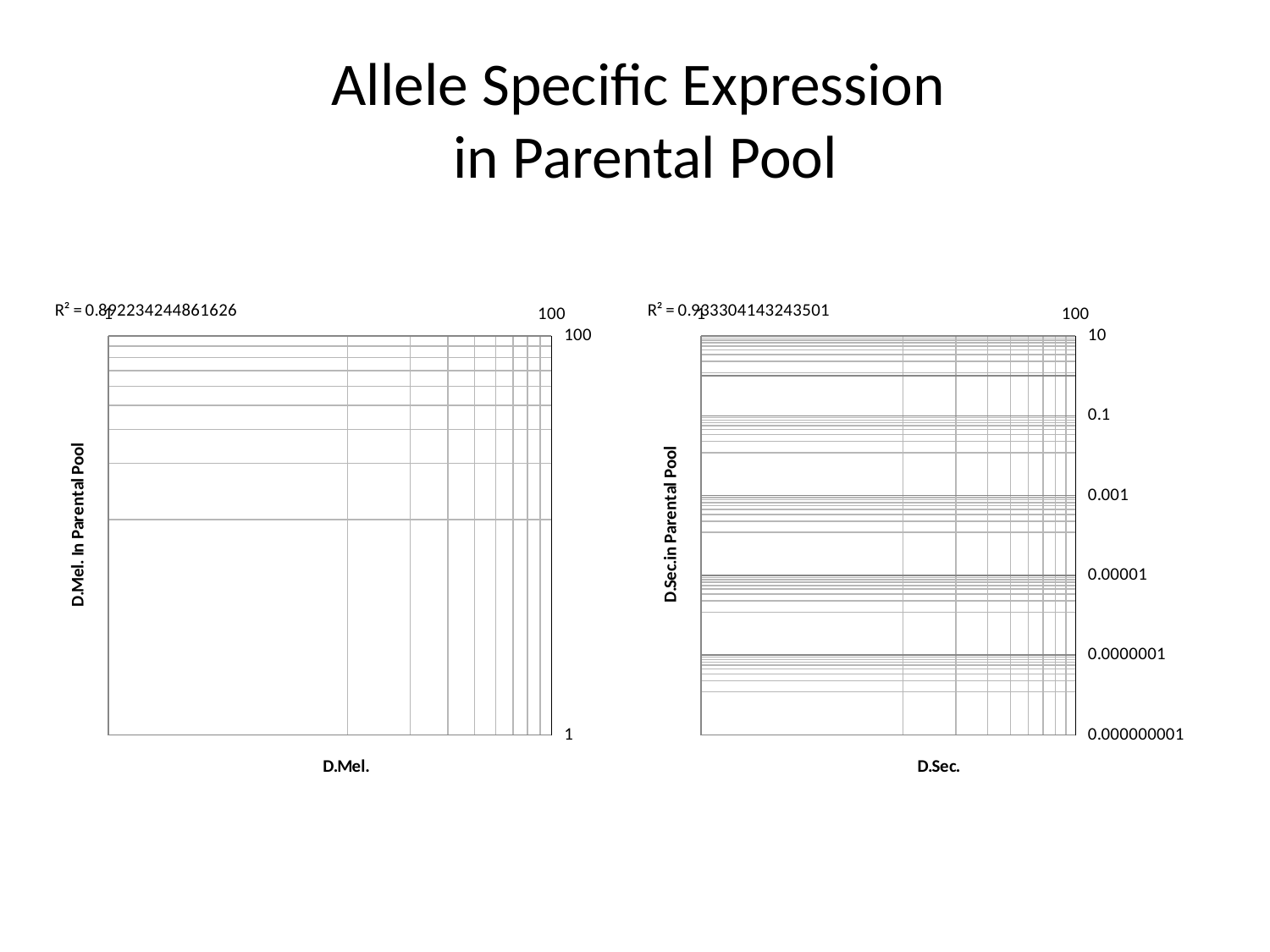
What kind of chart is the left chart, titled with x axis 'D.Mel.'? scatter chart Which chart shows the higher R² value, the left chart (D.Mel.) or the right chart (D.Sec.)? the right chart (D.Sec.) How many charts are shown on the slide? 2 What kind of chart is the right chart, titled with x axis 'D.Sec.'? scatter chart On the left chart, what is the y-axis title? D.Mel. In Parental Pool On the right chart, what is the x-axis title? D.Sec.